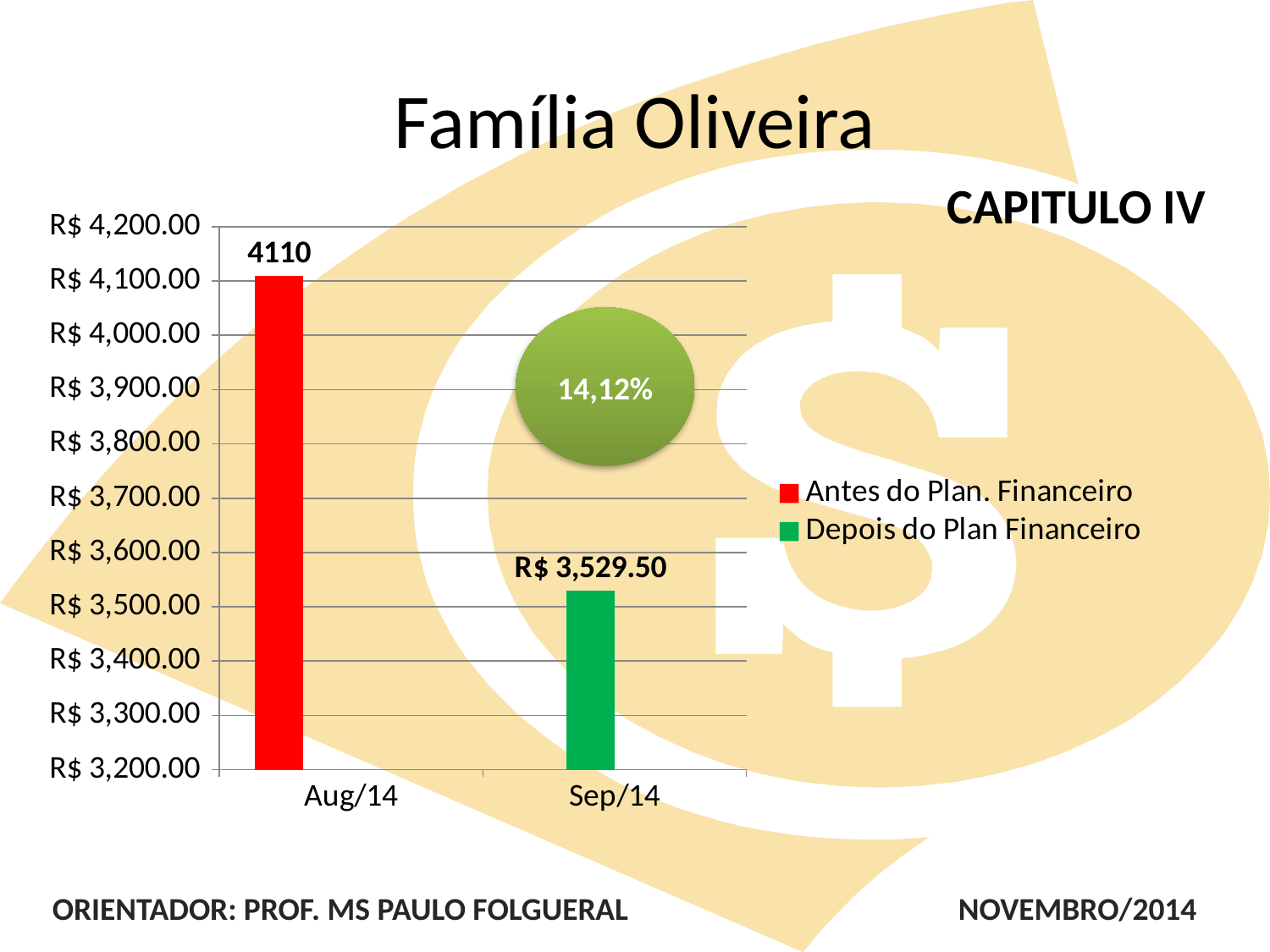
What is the difference between the Aug/14 value and the Sep/14 value? R$ 580.50 What is the value of the bar for Aug/14? 4110 Which category has the highest value in the chart? Aug/14 Is the value for Sep/14 greater or less than R$ 3,600.00? less Which category has the lowest value in the chart? Sep/14 What is the value of the bar for Sep/14? R$ 3,529.50 Which month has the higher bar, Aug/14 or Sep/14? Aug/14 What kind of chart is shown on the slide? bar chart How many series does the legend list? 2 Is the value for Aug/14 greater or less than R$ 4,000.00? greater Which legend entry is shown in green? Depois do Plan Financeiro How many categories are shown on the x axis of the chart? 2